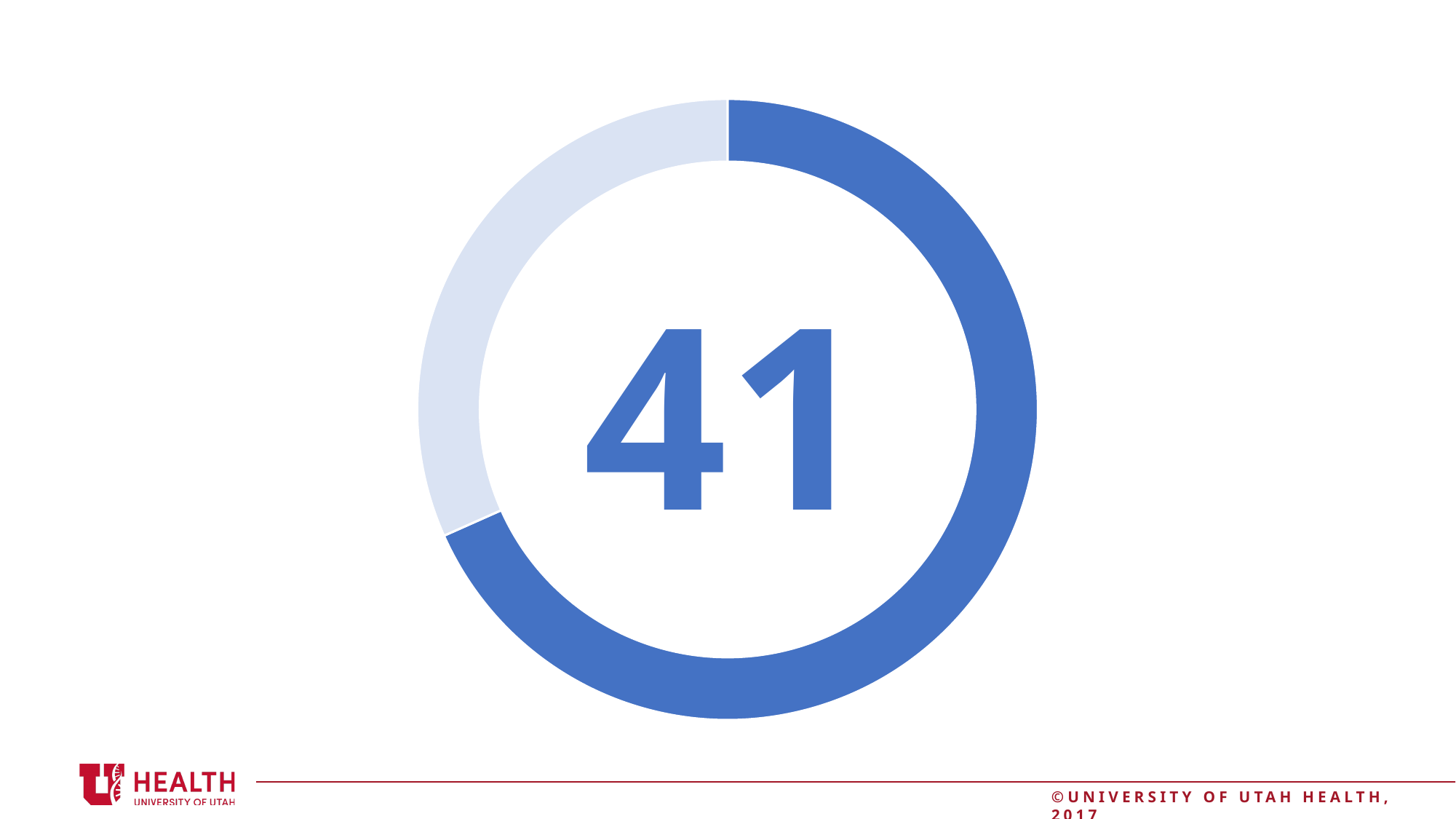
Which slice of the doughnut chart is larger, the dark blue one or the light blue one? The dark blue one What kind of chart is shown on the slide? Doughnut chart What two colours are used for the slices of the doughnut chart? Dark blue and light blue How many slices does the doughnut chart have? 2 Does the dark blue slice cover more or less than half of the doughnut ring? More What number is displayed in the center of the doughnut chart? 41